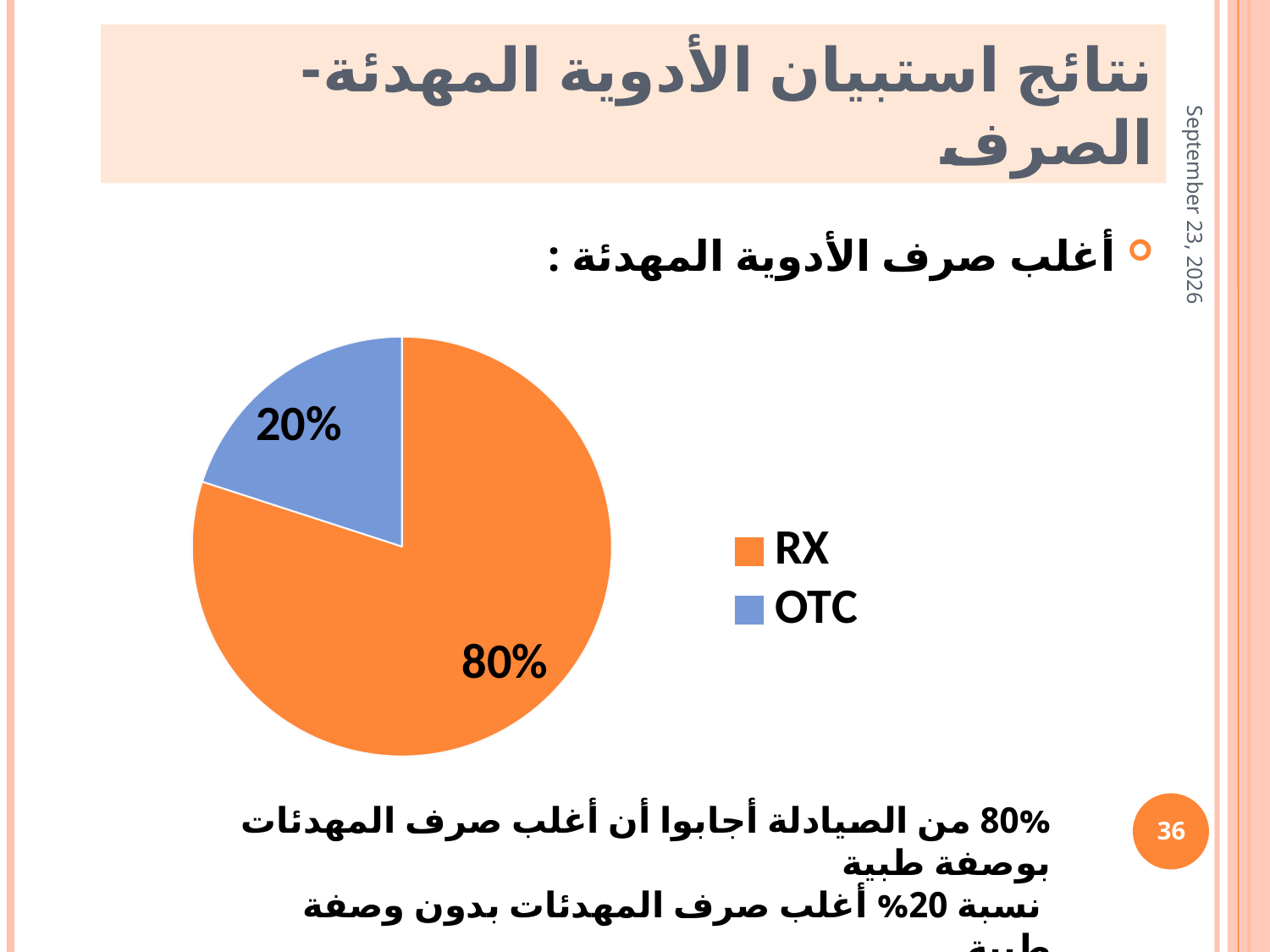
What kind of chart is shown on the slide? pie chart What is the difference in percentage points between the RX and OTC slices? 60% Which is larger, the RX slice or the OTC slice? RX What colour is the OTC slice in the pie chart? blue Which category has the smallest slice of the pie? OTC How many categories does the pie chart show? 2 What colour is the RX slice in the pie chart? orange How many entries does the legend list? 2 What share of the pie does RX account for? 80% Which category has the largest slice of the pie? RX What share of the pie does OTC account for? 20%